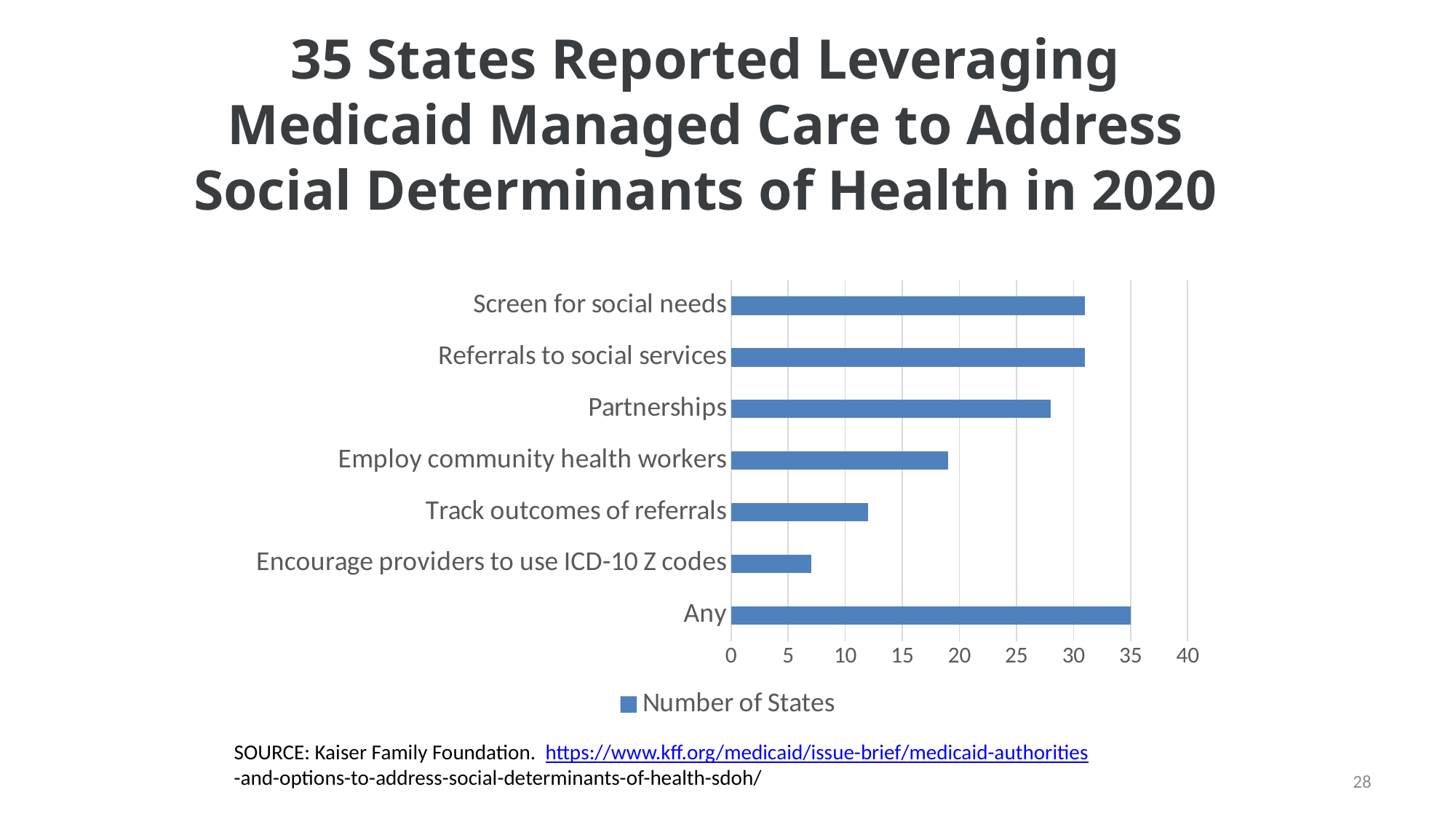
What is the number of states for the 'Any' category? 35 Is the value for 'Partnerships' greater or less than 25? greater How many categories are plotted in the chart? 7 What kind of chart is shown on the slide? bar chart Which has a larger number of states: 'Partnerships' or 'Employ community health workers'? Partnerships Is the value for 'Employ community health workers' greater or less than 20? less Is the value for 'Encourage providers to use ICD-10 Z codes' greater or less than 10? less What is the name of the series shown in the legend? Number of States Which category has the highest number of states? Any How many series does the legend list? 1 Which category has the lowest number of states? Encourage providers to use ICD-10 Z codes